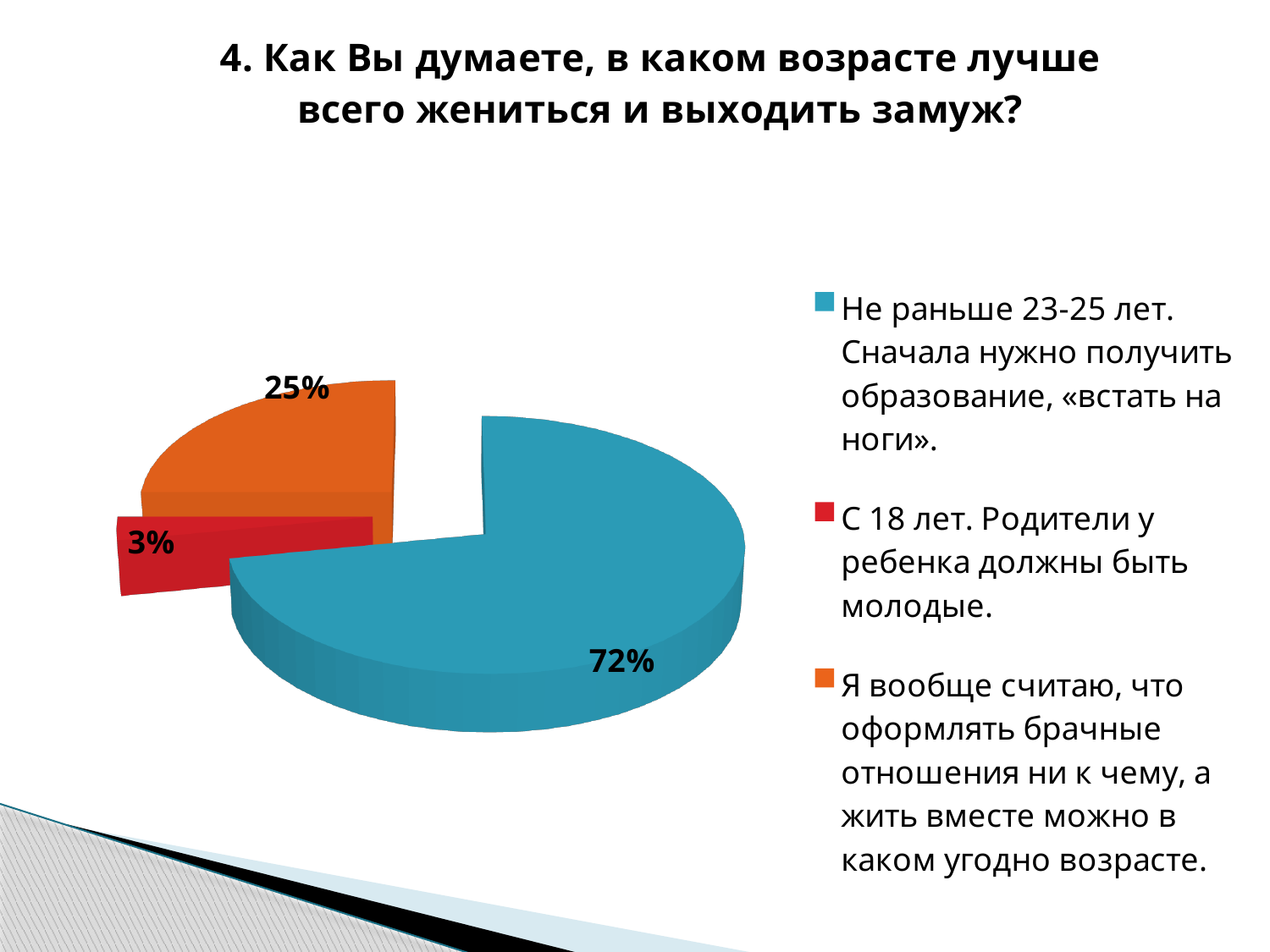
Which answer option has the smallest share of the pie? С 18 лет. Родители у ребенка должны быть молодые. How many entries does the legend list? 3 What colour is the slice representing "С 18 лет. Родители у ребенка должны быть молодые"? Red Which is larger: the share for "С 18 лет" or the share for "Я вообще считаю, что оформлять брачные отношения ни к чему"? Я вообще считаю, что оформлять брачные отношения ни к чему, а жить вместе можно в каком угодно возрасте. What share of the pie corresponds to "Не раньше 23-25 лет. Сначала нужно получить образование, «встать на ноги»"? 72% How many slices does the pie chart have? 3 Which answer option has the largest share of the pie? Не раньше 23-25 лет. Сначала нужно получить образование, «встать на ноги». What share of the pie corresponds to "С 18 лет. Родители у ребенка должны быть молодые"? 3% What share of the pie corresponds to "Я вообще считаю, что оформлять брачные отношения ни к чему, а жить вместе можно в каком угодно возрасте"? 25% What type of chart is shown on the slide? Pie chart What is the title of the slide with the pie chart? 4. Как Вы думаете, в каком возрасте лучше всего жениться и выходить замуж? What is the difference between the largest slice (72%) and the slice for "Я вообще считаю, что оформлять брачные отношения ни к чему..." (25%)? 47%